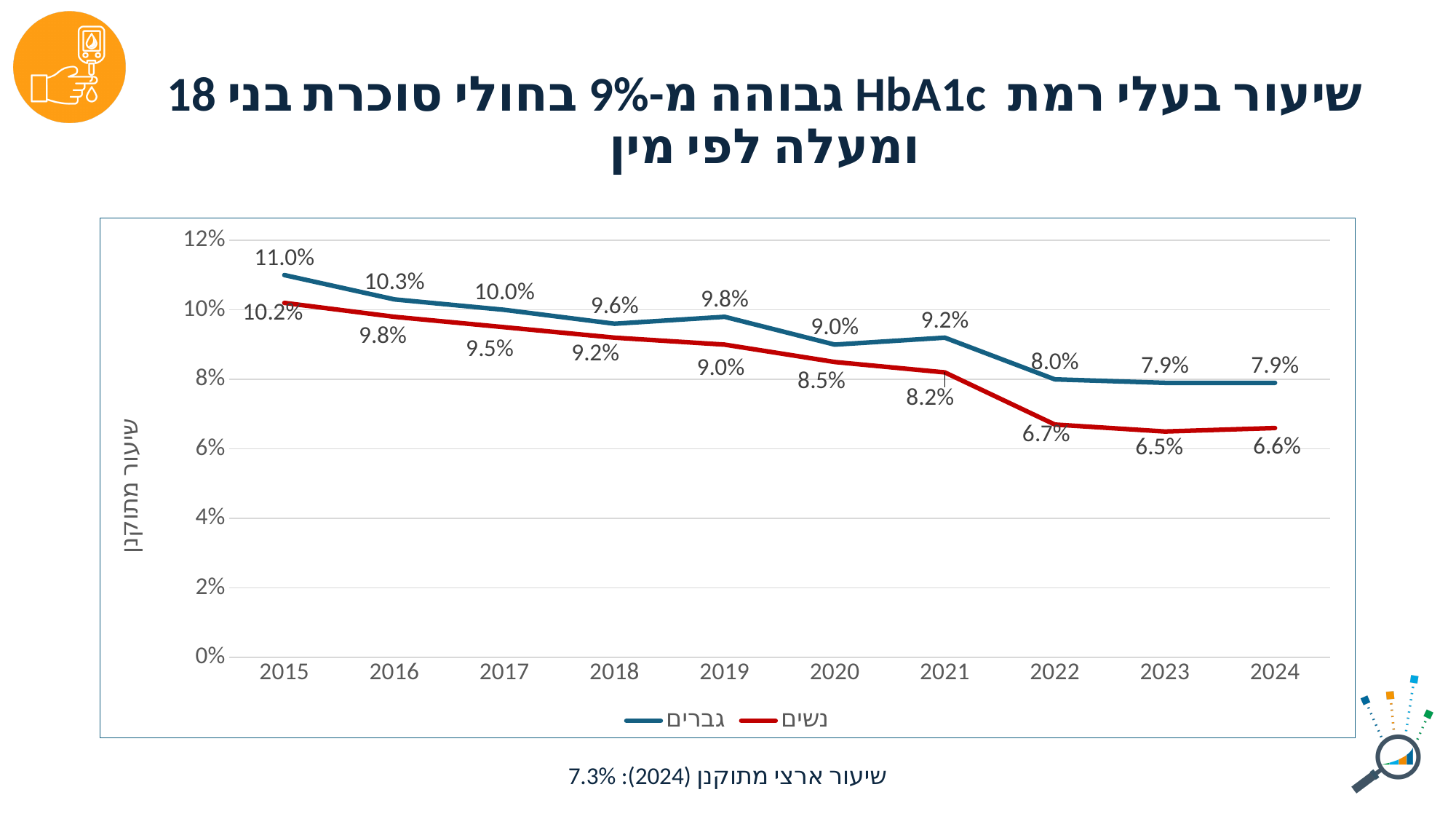
What type of chart is shown on the slide? line chart In which year is the value for נשים (women) lowest? 2023 How many years are shown on the x axis? 10 Do the values for נשים (women) generally rise or fall from 2015 to 2024? fall How many series does the legend list? 2 What is the value for נשים (women) in 2021? 8.2% In which year is the value for גברים (men) highest? 2015 What is the value for נשים (women) in 2024? 6.6% What is the difference between the גברים (men) and נשים (women) values in 2022? 1.3% What is the value for גברים (men) in 2015? 11.0% Which series has the larger value in 2019, גברים (men) or נשים (women)? גברים (men) Which colour is used for the נשים (women) series? red